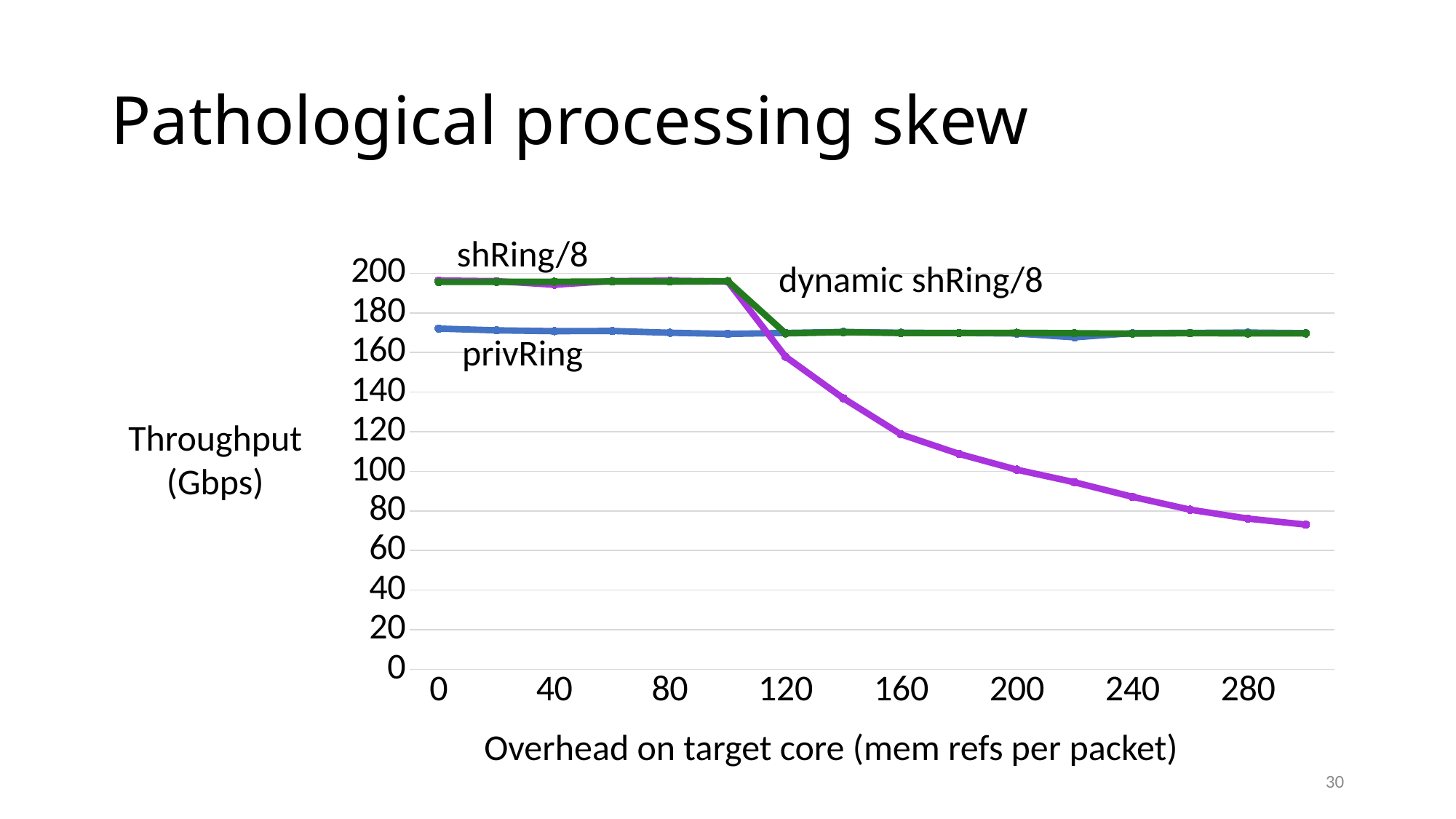
Is the throughput of shRing/8 at an overhead of 280 greater or less than 100? less At an overhead of 200, which series has the higher throughput, shRing/8 or dynamic shRing/8? dynamic shRing/8 At an overhead of 280, which series has the higher throughput, privRing or shRing/8? privRing Does the throughput of shRing/8 rise or fall as the overhead on the target core increases beyond 100? fall Which series has the lowest throughput at the right end of the x axis? shRing/8 What kind of chart is shown on the slide? line chart What is the title of the slide containing the chart? Pathological processing skew What is the label of the x axis of the chart? Overhead on target core (mem refs per packet) How many data series are plotted on the chart? 3 Is the throughput of privRing at an overhead of 0 greater or less than 160? greater Is the throughput of shRing/8 at an overhead of 0 greater or less than 180? greater